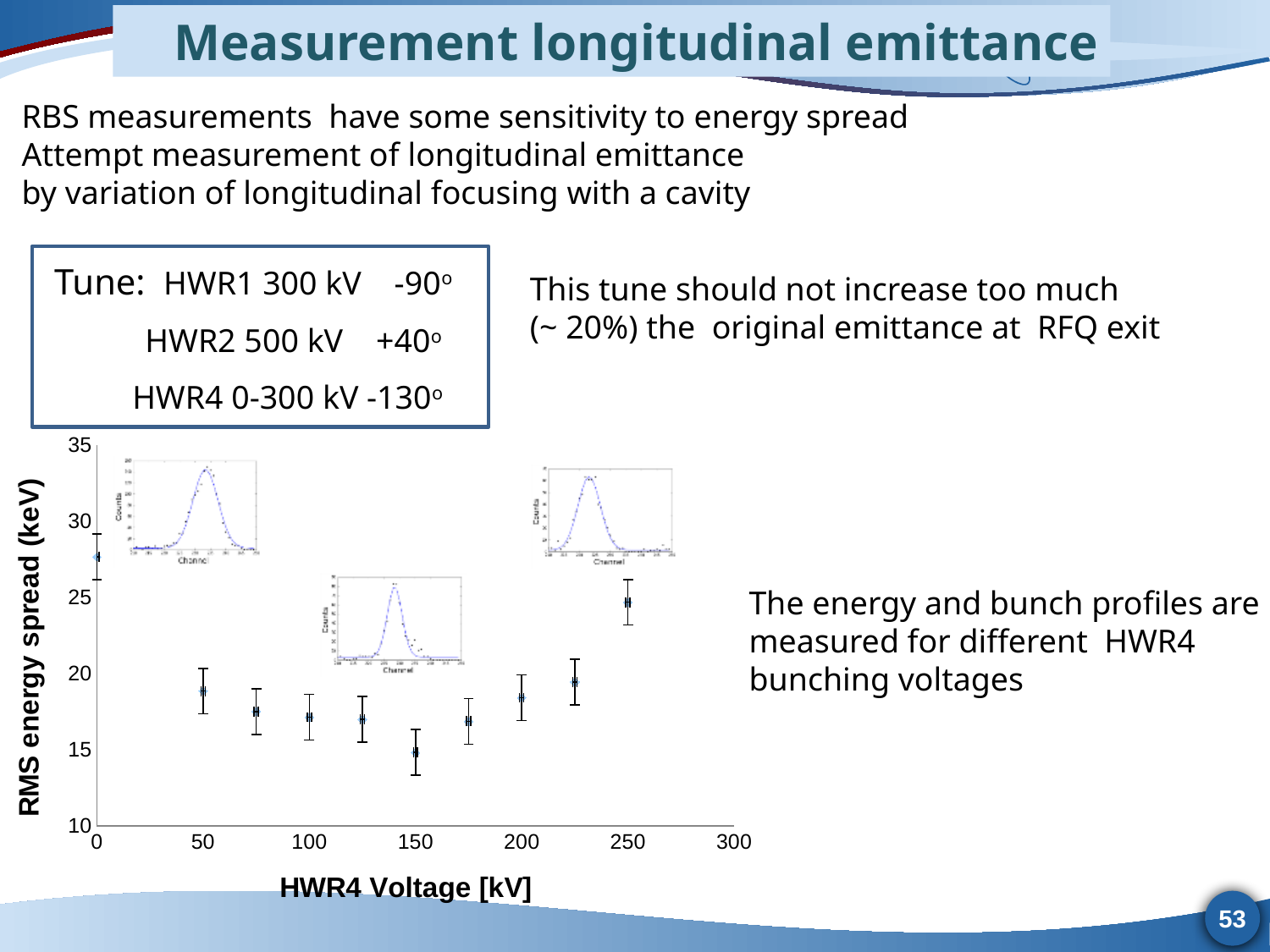
Is the RMS energy spread at 0 kV greater or less than 25 keV? greater At which HWR4 voltage is the RMS energy spread highest? 0 kV At which HWR4 voltage is the RMS energy spread lowest? 150 kV Which has a larger RMS energy spread, 250 kV or 50 kV? 250 kV What kind of chart is shown on the slide? Scatter plot with error bars Is the RMS energy spread at 250 kV greater or less than 20 keV? greater How many data points are plotted in the chart? 10 Is the RMS energy spread at 100 kV greater or less than 20 keV? less What is the label of the x axis of the chart? HWR4 Voltage [kV] How does the RMS energy spread change as the HWR4 voltage increases from 0 to 250 kV? It falls to a minimum around 150 kV, then rises What is the label of the y axis of the chart? RMS energy spread (keV)